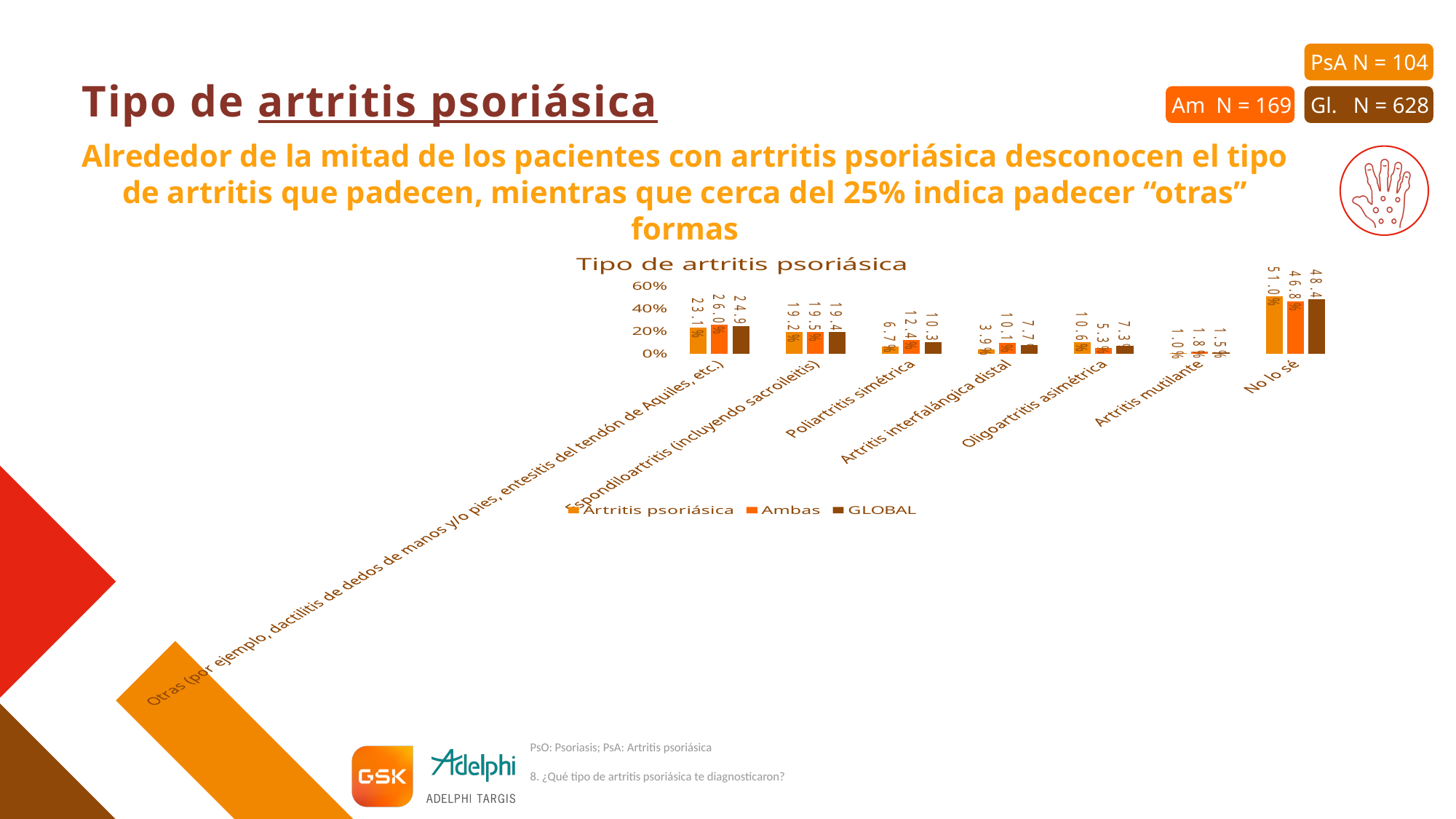
Which category has the lowest value in the 'Ambas' series? Artritis mutilante What is the value for 'No lo sé' in the 'Artritis psoriásica' series? 51.0% How many series does the legend list in the chart 'Tipo de artritis psoriásica'? 3 What is the difference between the 'Artritis psoriásica' and 'Ambas' values for 'No lo sé'? 4.2% For 'Oligoartritis asimétrica', which is larger: the 'Artritis psoriásica' value or the 'Ambas' value? Artritis psoriásica What is the value for 'No lo sé' in the 'Ambas' series? 46.8% Is the 'GLOBAL' value for 'No lo sé' greater or less than 40%? greater What type of chart is shown on the slide? Bar chart How many categories are shown on the x axis of the chart? 7 Which category has the highest value in the 'Artritis psoriásica' series? No lo sé What is the value for 'Poliartritis simétrica' in the 'Ambas' series? 12.4% What is the value for 'Artritis mutilante' in the 'Artritis psoriásica' series? 1.0%